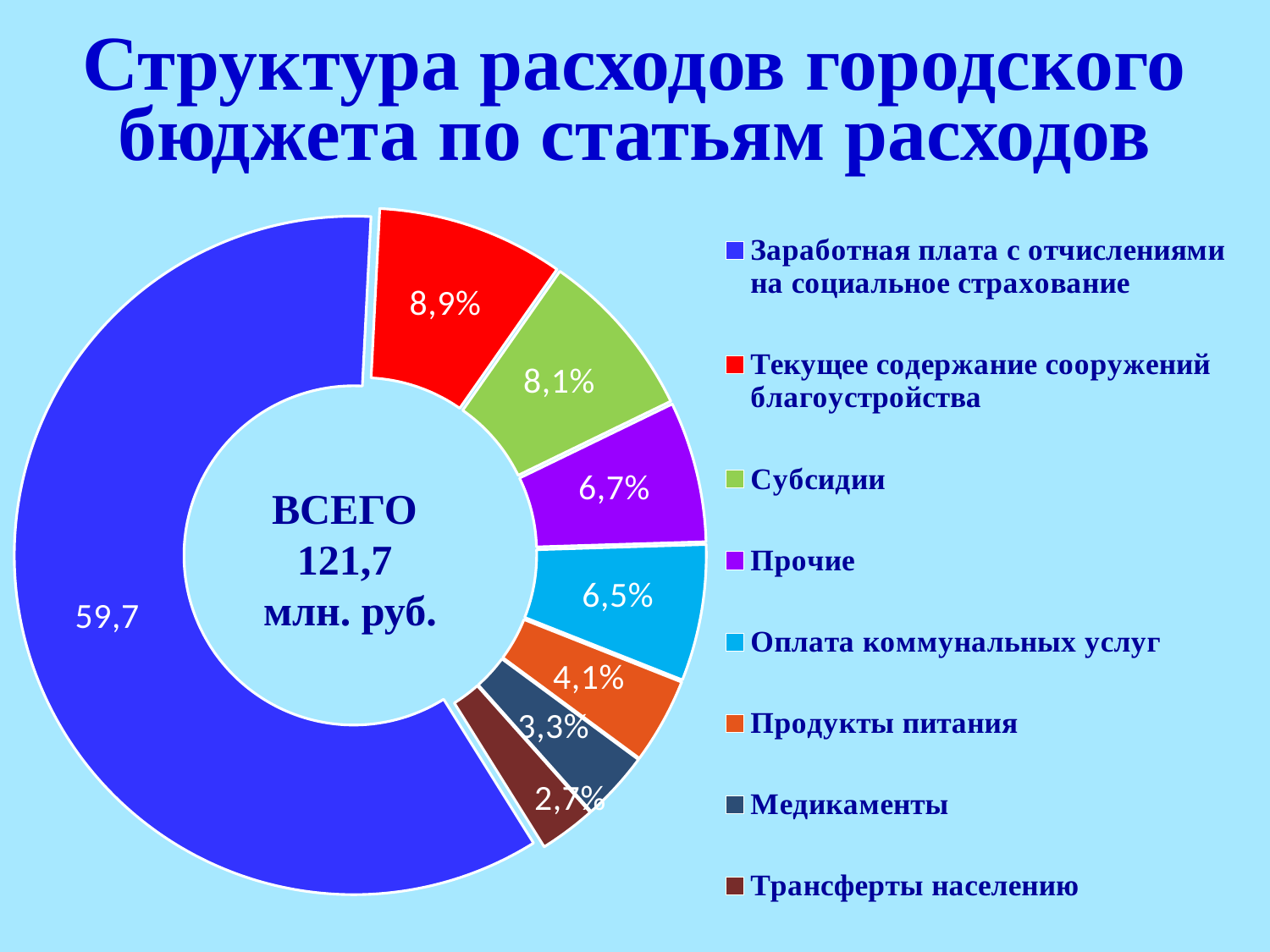
What percentage is shown for Трансферты населению? 2,7% Which category has the largest share of the chart? Заработная плата с отчислениями на социальное страхование What percentage is shown for Текущее содержание сооружений благоустройства? 8,9% What is the difference between the shares for Текущее содержание сооружений благоустройства and Субсидии? 0,8% What percentage is shown for Субсидии? 8,1% Which category has the smallest share of the chart? Трансферты населению What kind of chart is shown on the slide? Doughnut chart What is the value shown for Заработная плата с отчислениями на социальное страхование? 59,7 How many categories does the legend list? 8 What total amount is written in the centre of the chart? ВСЕГО 121,7 млн. руб. What percentage is shown for Оплата коммунальных услуг? 6,5% Which is larger, the share for Продукты питания or the share for Медикаменты? Продукты питания